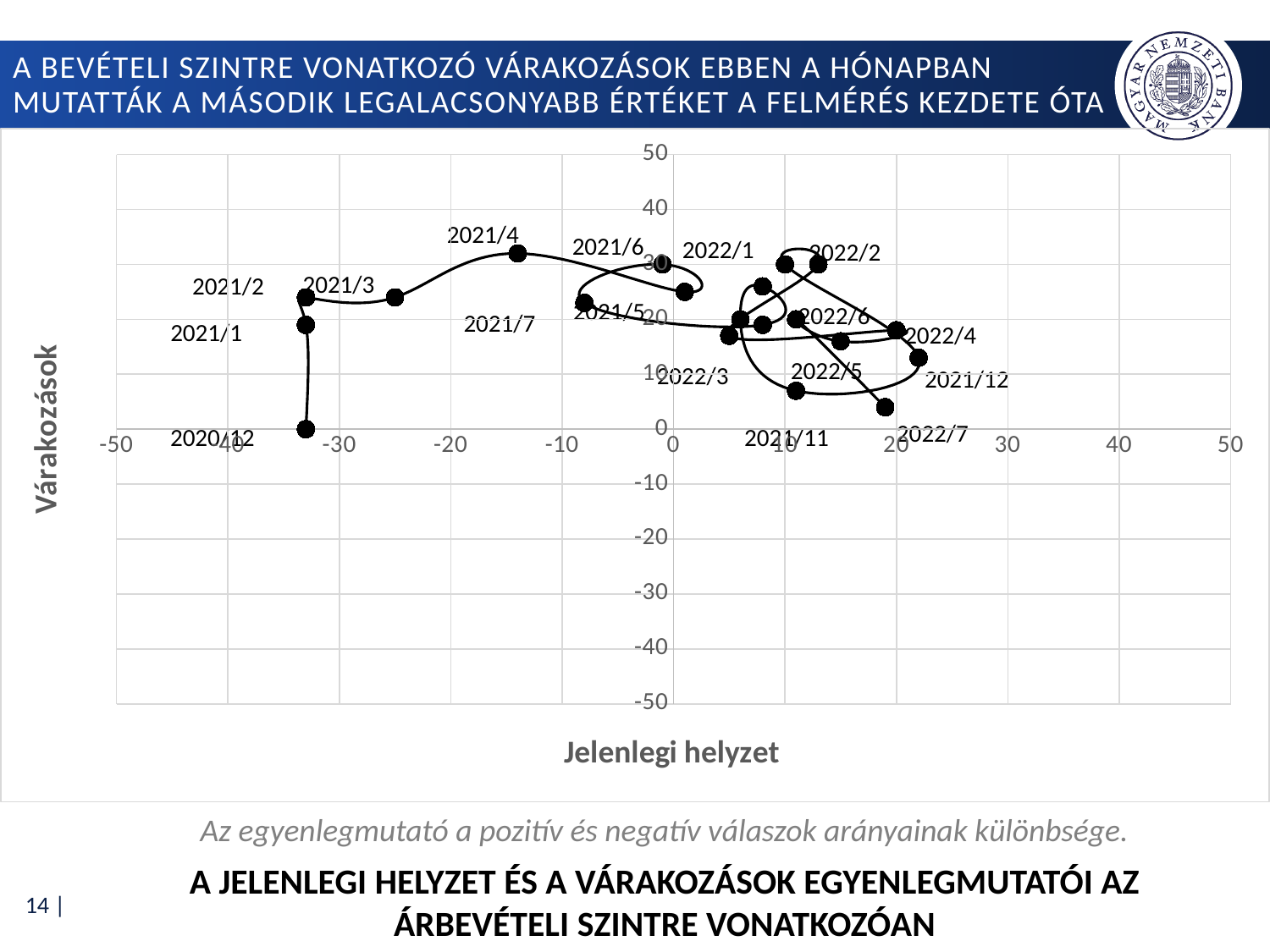
Is the Jelenlegi helyzet value for 2021/4 greater or less than 0? less What is the title of the vertical axis of the chart? Várakozások Is the Várakozások value for 2022/7 greater or less than 10? less Is the Jelenlegi helyzet value for 2021/12 greater or less than 10? greater Which labelled point has the lowest Várakozások value? 2020/12 What is the title of the horizontal axis of the chart? Jelenlegi helyzet Which point has the higher Jelenlegi helyzet value, 2020/12 or 2022/4? 2022/4 What kind of chart is shown on the slide? scatter chart Which point has the higher Várakozások value, 2021/4 or 2022/7? 2021/4